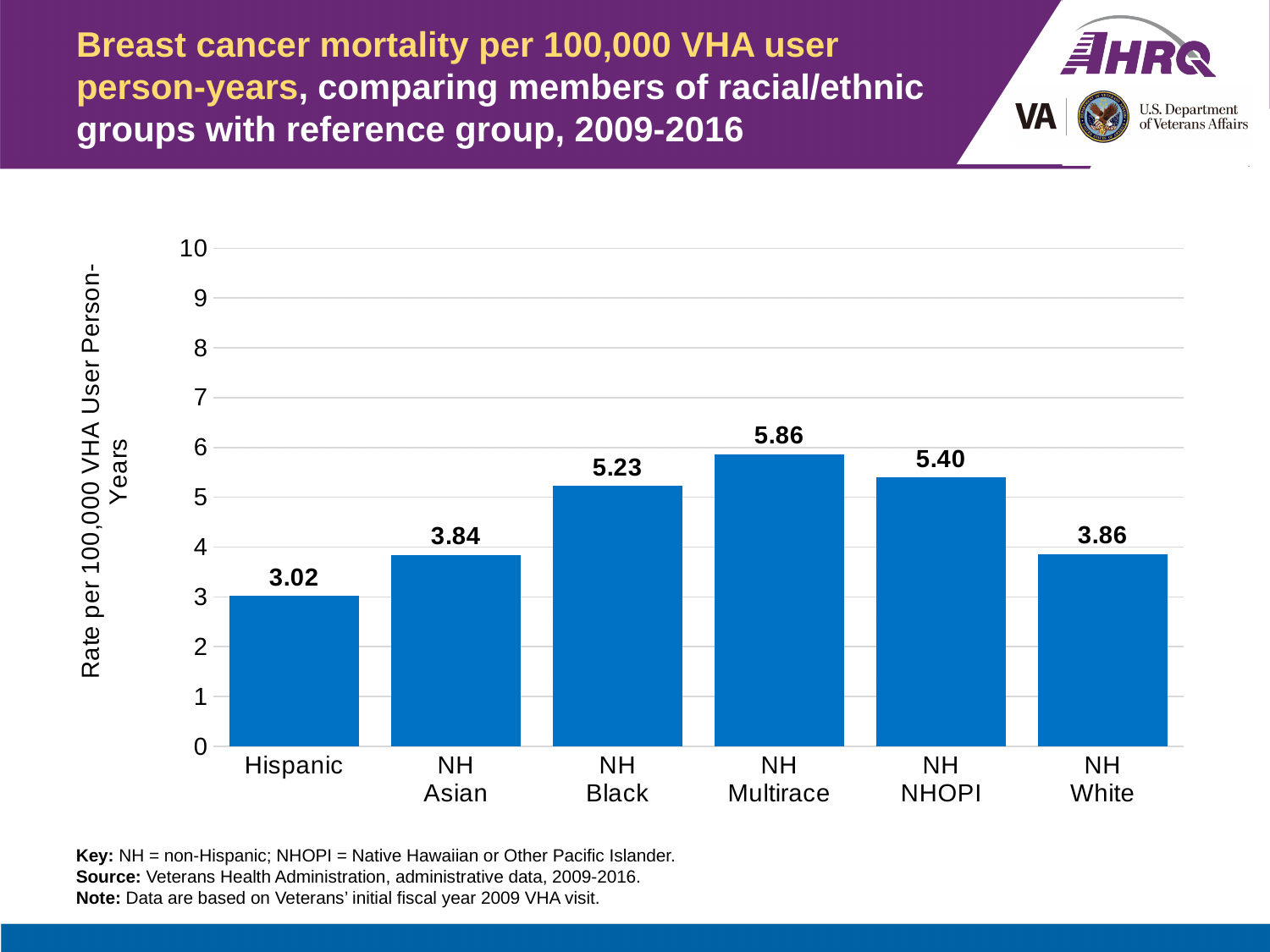
What is the rate shown for NH Black Veterans? 5.23 Is the rate for NH Multirace greater or less than 5? greater What is the label of the vertical axis? Rate per 100,000 VHA User Person-Years Which racial/ethnic group has the highest breast cancer mortality rate on the chart? NH Multirace Which racial/ethnic group has the lowest breast cancer mortality rate on the chart? Hispanic What kind of chart is shown on the slide? Bar chart What is the breast cancer mortality rate per 100,000 VHA user person-years for Hispanic Veterans? 3.02 What is the rate shown for NH NHOPI Veterans? 5.40 What is the difference between the rates for NH Multirace and Hispanic Veterans? 2.84 What is the difference between the rates for NH Black and NH Asian Veterans? 1.39 Which group has a higher rate, NH NHOPI or NH White? NH NHOPI How many racial/ethnic groups are shown on the chart? 6